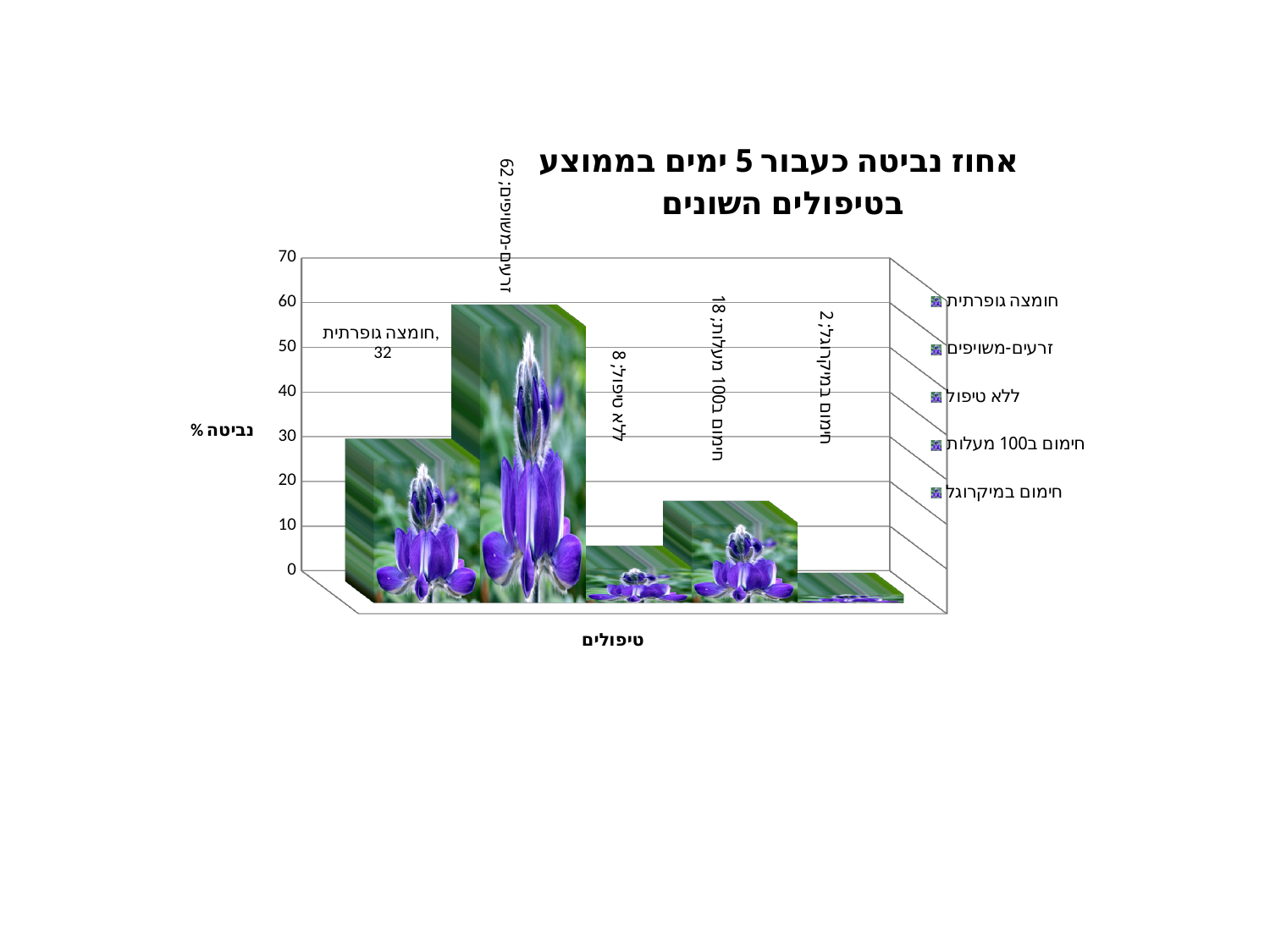
Which is larger, the value for חימום ב100 מעלות or the value for ללא טיפול? חימום ב100 מעלות Which treatment has the lowest value? חימום במיקרוגל What is the value for זרעים-משויפים? 62 What is the value for חומצה גופרתית? 32 How many treatments are shown in the chart? 5 What is the difference between the values for זרעים-משויפים and חומצה גופרתית? 30 What is the value for ללא טיפול? 8 What is the label of the vertical axis? נביטה % Which treatment has the highest value? זרעים-משויפים What is the value for חימום ב100 מעלות? 18 What is the value for חימום במיקרוגל? 2 What kind of chart is shown on the slide? bar chart